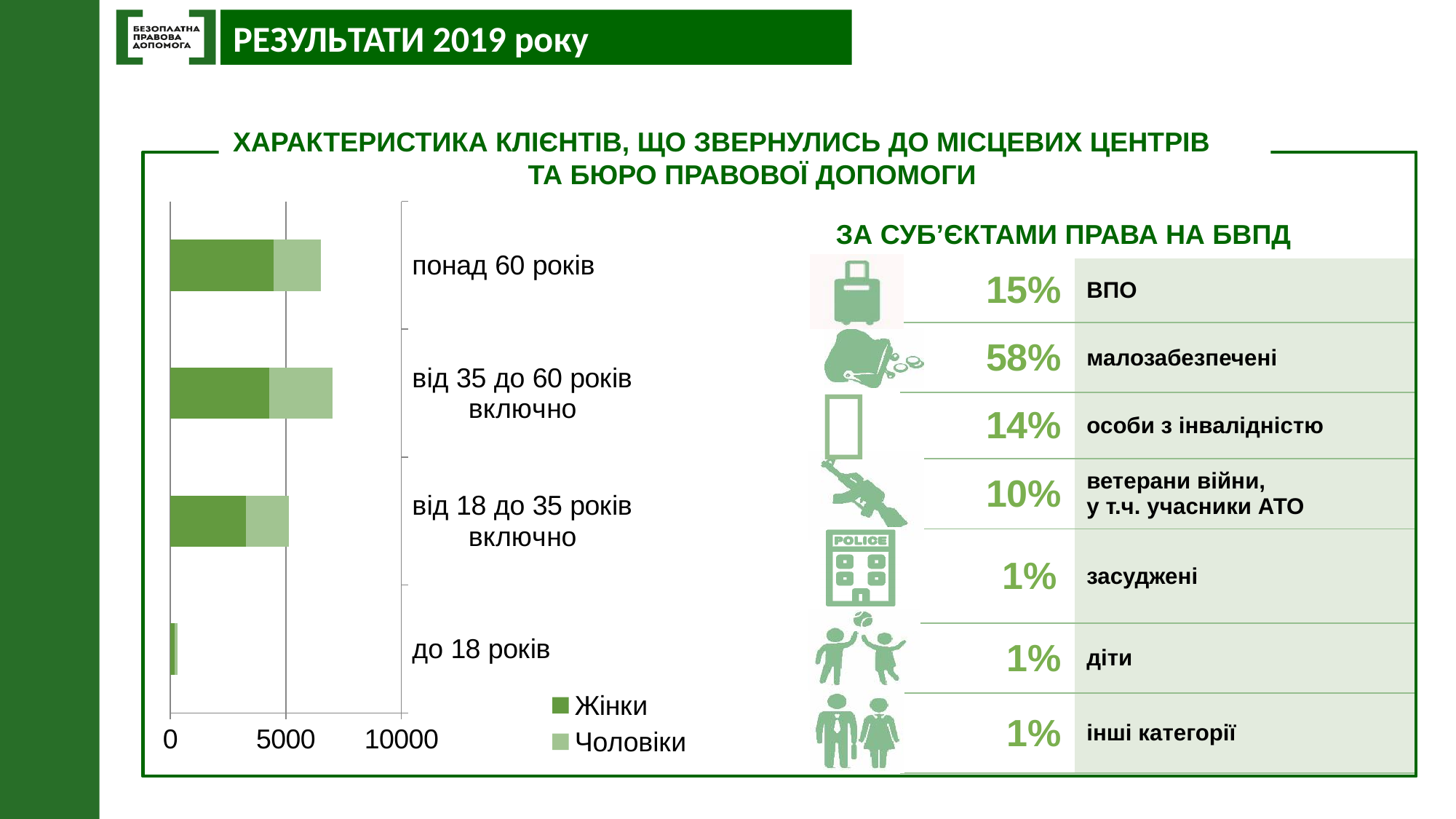
What is the highest value shown on the horizontal axis of the bar chart? 10000 Which age category has the longest total bar in the bar chart? від 35 до 60 років включно Is the total bar for 'до 18 років' greater or less than 5000? less What are the two series named in the legend of the bar chart? Жінки and Чоловіки How many age categories does the bar chart show? 4 Is the total bar for 'понад 60 років' greater or less than 5000? greater Is the Жінки value for 'від 18 до 35 років включно' greater or less than 5000? less How many series does the legend of the bar chart list? 2 Which age category has the shortest total bar in the bar chart? до 18 років What kind of chart is shown on the left of the slide? bar chart For 'понад 60 років', which series has the larger value, Жінки or Чоловіки? Жінки